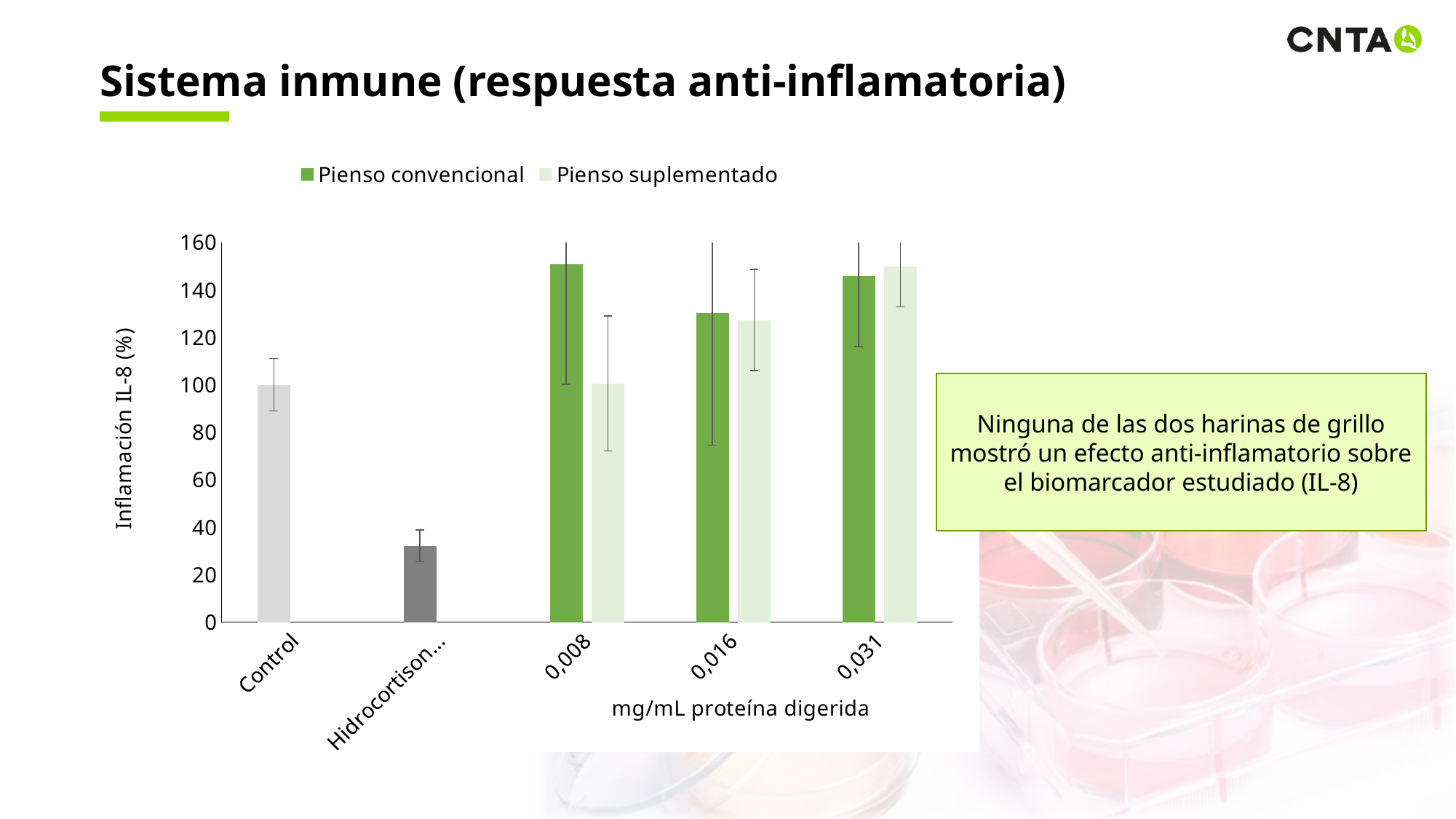
What kind of chart is shown on the slide? bar chart Which category has the lowest bar in the chart? Hidrocortison... Which category has the highest Pienso suplementado bar? 0,031 Is the Pienso suplementado value at 0,031 greater or less than 140? greater At 0,008, which is larger: Pienso convencional or Pienso suplementado? Pienso convencional What is the title of the y axis? Inflamación IL-8 (%) Is the Pienso suplementado value at 0,008 greater or less than 120? less How many series does the legend list? 2 How many categories are shown on the x axis? 5 Is the value for Hidrocortison... greater or less than 40? less